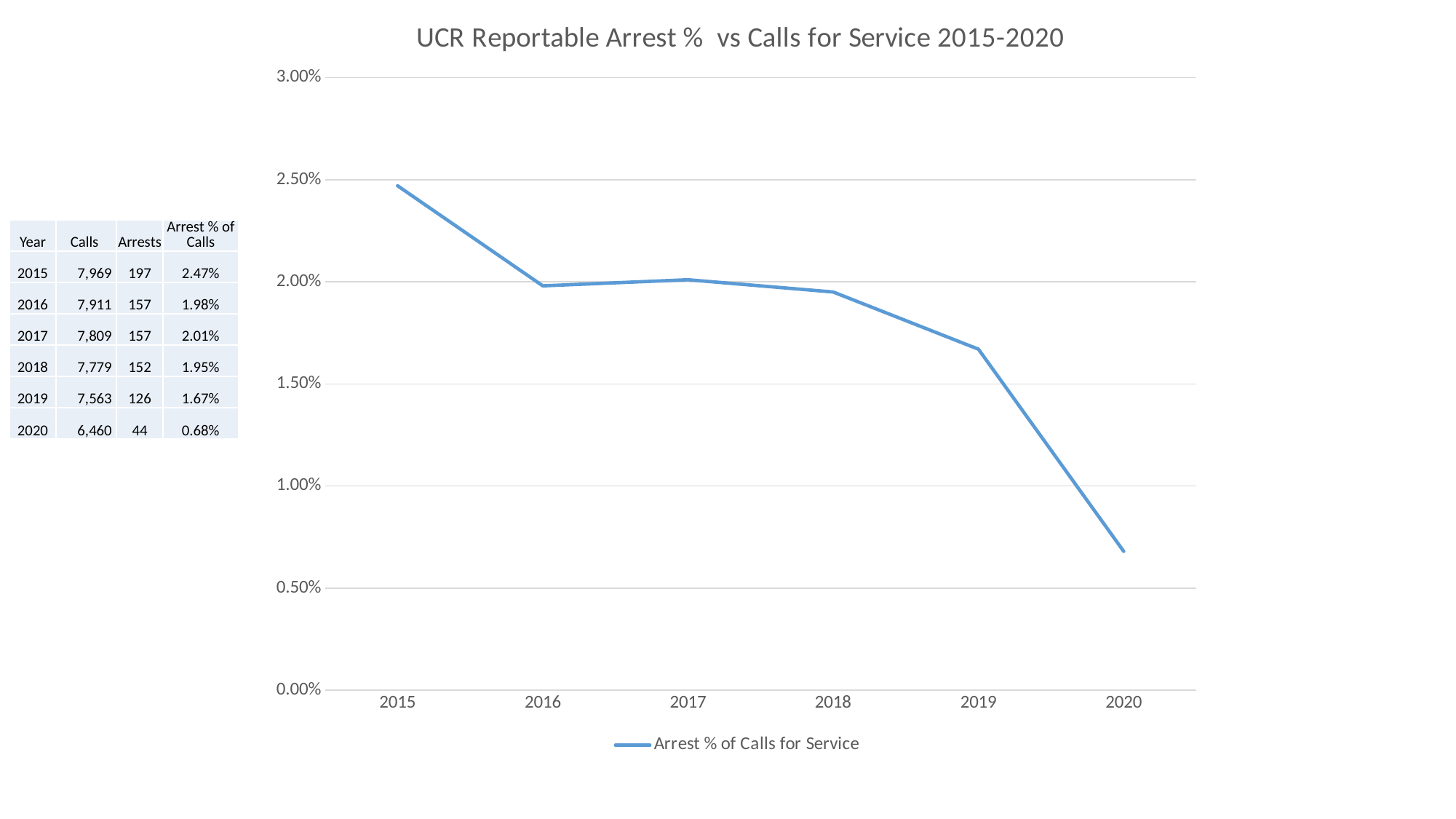
What is the Arrest % of Calls for Service value for 2020? 0.68% Does the Arrest % of Calls for Service generally rise or fall from 2015 to 2020? fall Is the Arrest % of Calls for Service value for 2019 greater or less than 2.00%? less What is the Arrest % of Calls for Service value for 2015? 2.47% How many series does the legend list? 1 What kind of chart is shown on the slide? line chart Which is larger, the Arrest % of Calls for Service for 2017 or for 2019? 2017 How many years are plotted on the x axis? 6 What is the title of the chart? UCR Reportable Arrest % vs Calls for Service 2015-2020 Which year has the highest Arrest % of Calls for Service? 2015 Which year has the lowest Arrest % of Calls for Service? 2020 What is the Arrest % of Calls for Service value for 2019? 1.67%